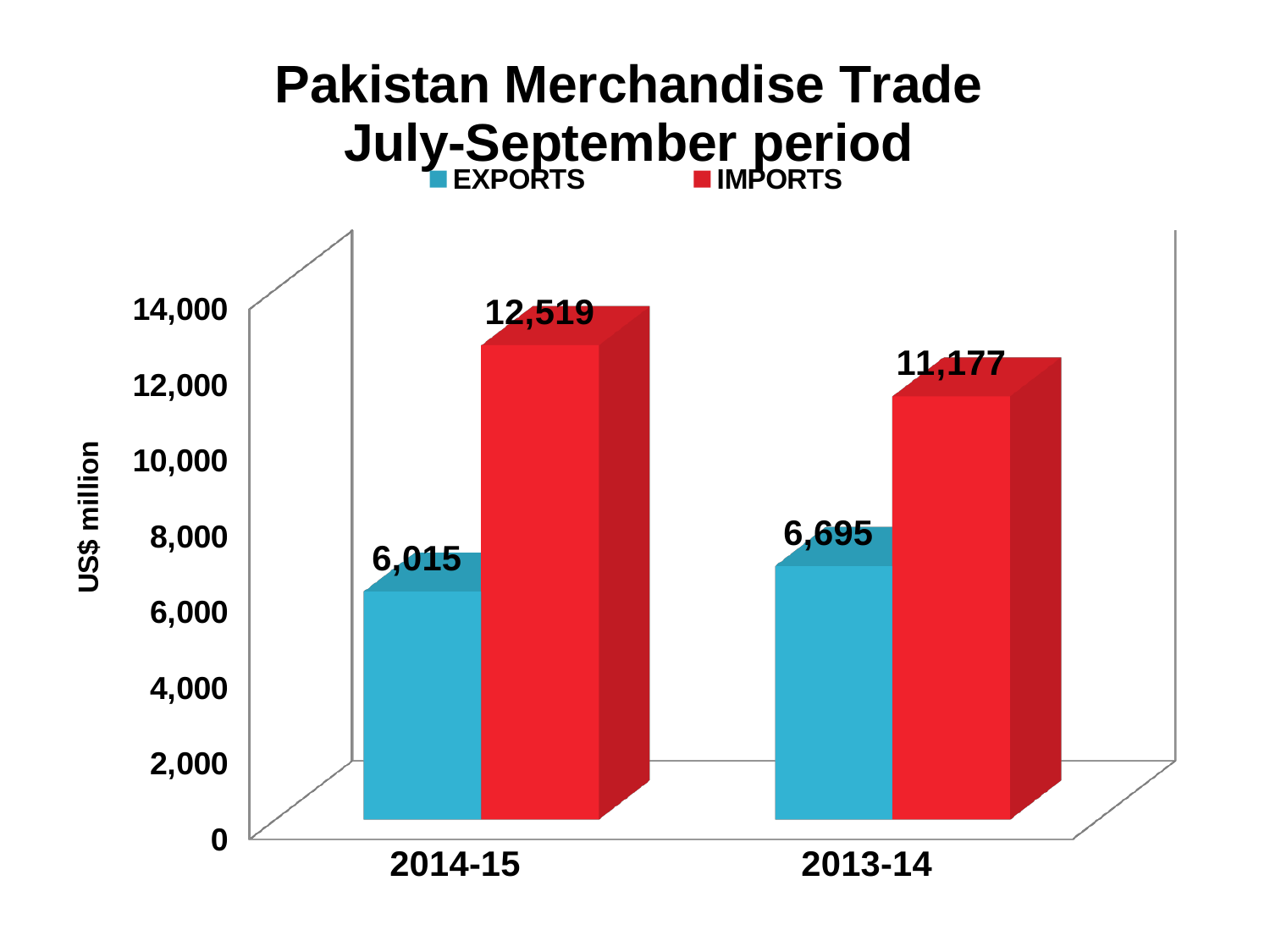
What is the value of EXPORTS for 2014-15? 6,015 Which is larger: EXPORTS in 2013-14 or EXPORTS in 2014-15? EXPORTS in 2013-14 What kind of chart is shown on the slide? Bar chart What is the label of the vertical axis? US$ million How many series does the legend list? 2 Which year has the higher IMPORTS value? 2014-15 What is the difference between IMPORTS in 2014-15 and IMPORTS in 2013-14? 1,342 Which year has the lower EXPORTS value? 2014-15 What is the value of IMPORTS for 2014-15? 12,519 What is the value of EXPORTS for 2013-14? 6,695 What is the difference between IMPORTS and EXPORTS in 2014-15? 6,504 What is the value of IMPORTS for 2013-14? 11,177